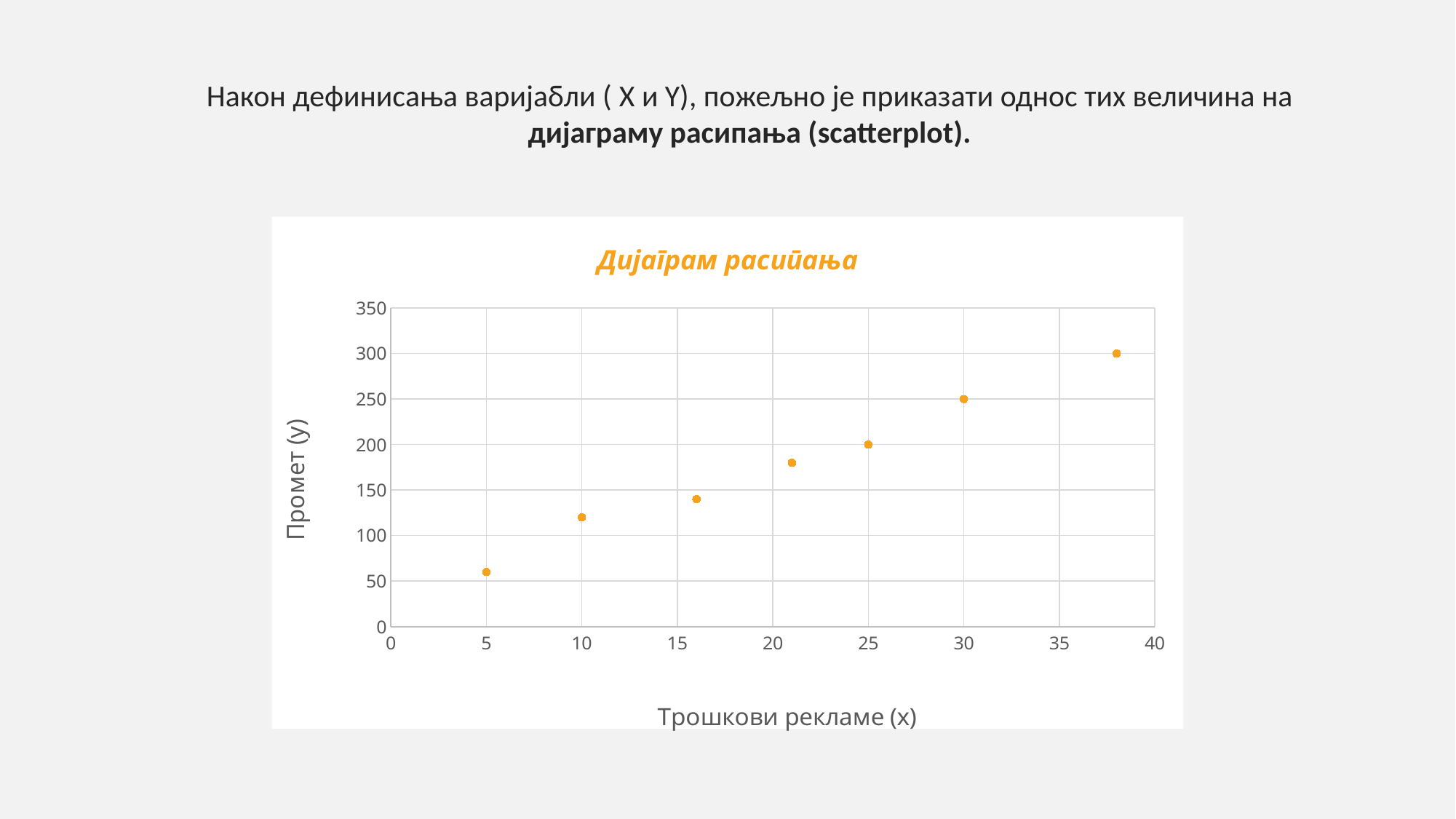
Which point has the highest y value, the one at x = 30 or the rightmost point? The rightmost point What is the y value (Промет) of the point at x = 25? 200 Is the y value of the point at x = 5 greater or less than 100? less What kind of chart is shown on the slide? Scatter plot Do the y values rise or fall as x increases along the chart? Rise What is the y value (Промет) of the point at x = 30? 250 Is the y value of the point at x = 21 greater or less than 200? less Is the y value of the point at x = 10 greater or less than 100? greater What is the difference in y value between the point at x = 30 and the point at x = 25? 50 What is the label of the x axis? Трошкови рекламе (x) How many data points are plotted on the chart? 7 What is the y value of the rightmost point on the chart? 300